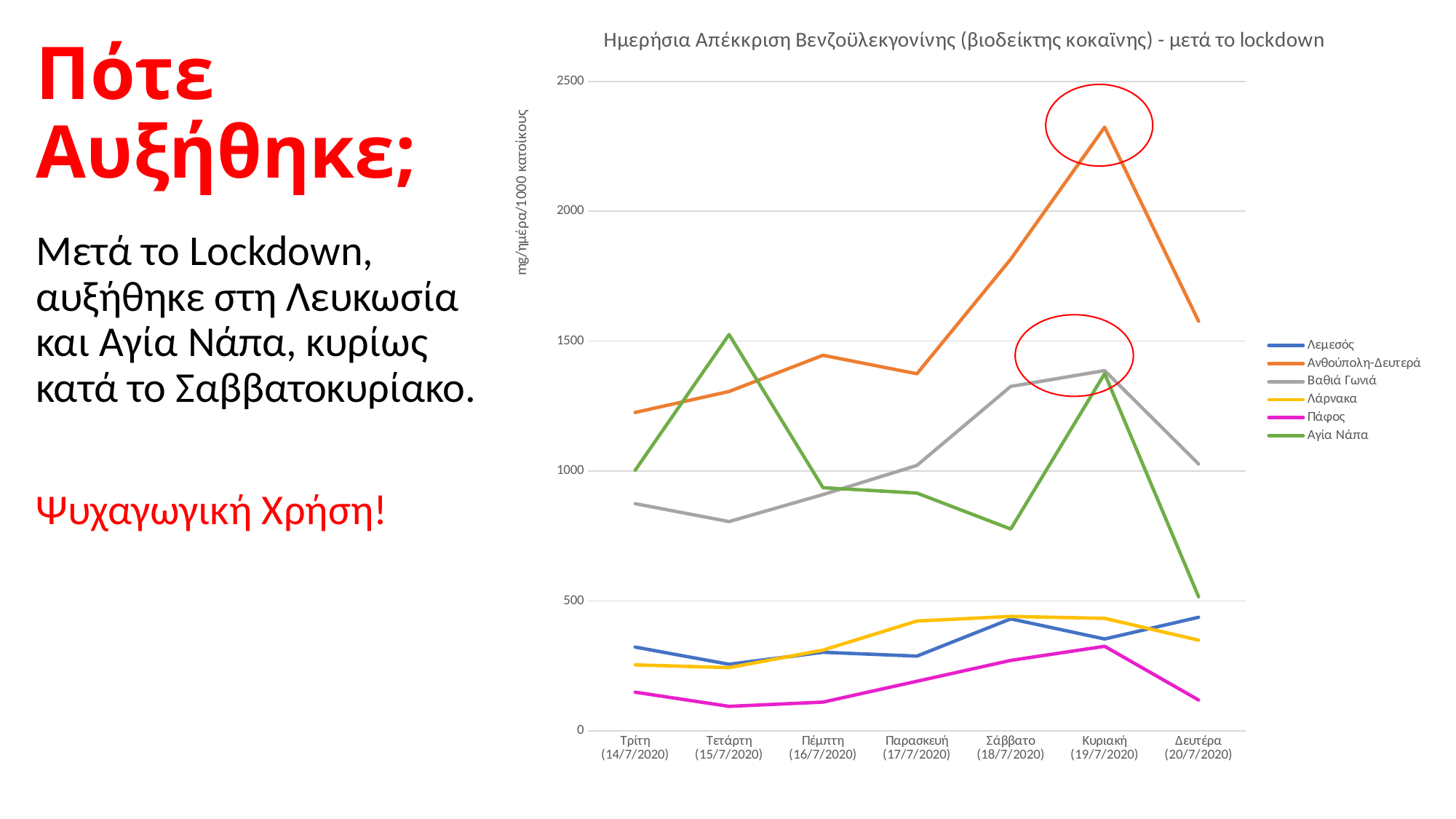
Does the value for Αγία Νάπα rise or fall from Κυριακή (19/7/2020) to Δευτέρα (20/7/2020)? fall On Τετάρτη (15/7/2020), which is larger: Αγία Νάπα or Ανθούπολη-Δευτερά? Αγία Νάπα What kind of chart is shown on the slide? line chart Is the value for Πάφος on Δευτέρα (20/7/2020) greater or less than 500? less How many days are plotted along the x axis? 7 Which series has the lowest value on Τρίτη (14/7/2020)? Πάφος Which series has the highest value on Κυριακή (19/7/2020)? Ανθούπολη-Δευτερά Is the value for Ανθούπολη-Δευτερά on Κυριακή (19/7/2020) greater or less than 2000? greater What is the label on the y axis of the chart? mg/ημέρα/1000 κατοίκους How many series does the legend list? 6 Is the value for Βαθιά Γωνιά on Κυριακή (19/7/2020) greater or less than 1000? greater What is the title of the chart? Ημερήσια Απέκκριση Βενζοϋλεκγονίνης (βιοδείκτης κοκαϊνης) - μετά το lockdown